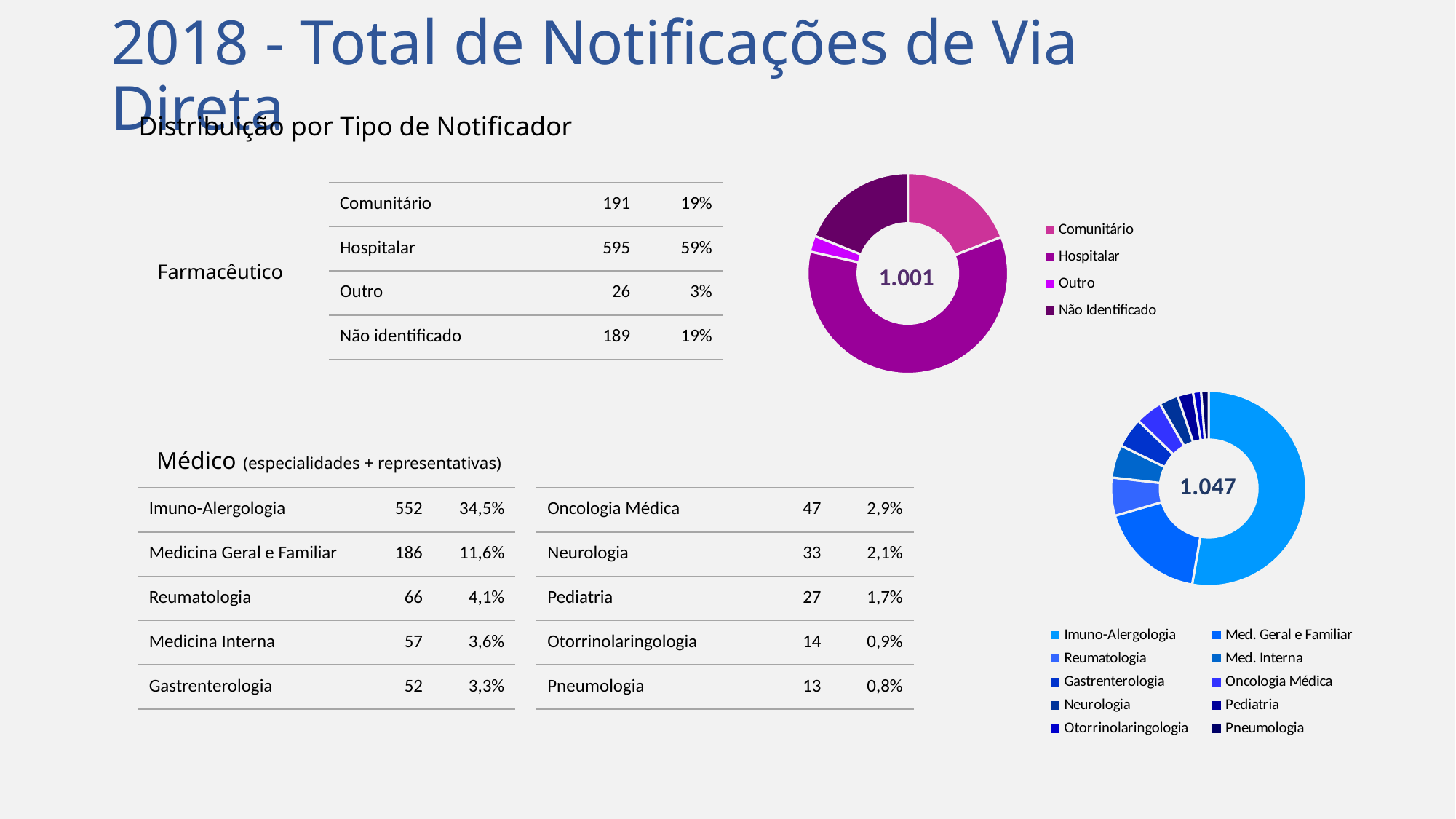
In the bottom chart (Médico), what is the value for Imuno-Alergologia? 552 In the bottom chart (Médico), which specialty has the smallest slice? Pneumologia What kind of chart is the top chart (Farmacêutico)? Donut (pie) chart In the top chart (Farmacêutico), which category has the smallest slice? Outro In the top chart (Farmacêutico), which category has the largest slice? Hospitalar How many categories does the legend of the bottom chart (Médico) list? 10 In the top chart (Farmacêutico), what share does Comunitário have? 19% What total is shown in the centre of the top chart (Farmacêutico)? 1.001 How many categories does the legend of the top chart (Farmacêutico) list? 4 In the bottom chart (Médico), what is the difference between Reumatologia and Medicina Interna? 9 In the bottom chart (Médico), what share does Medicina Geral e Familiar have? 11,6% In the top chart (Farmacêutico), what is the value for Hospitalar? 595